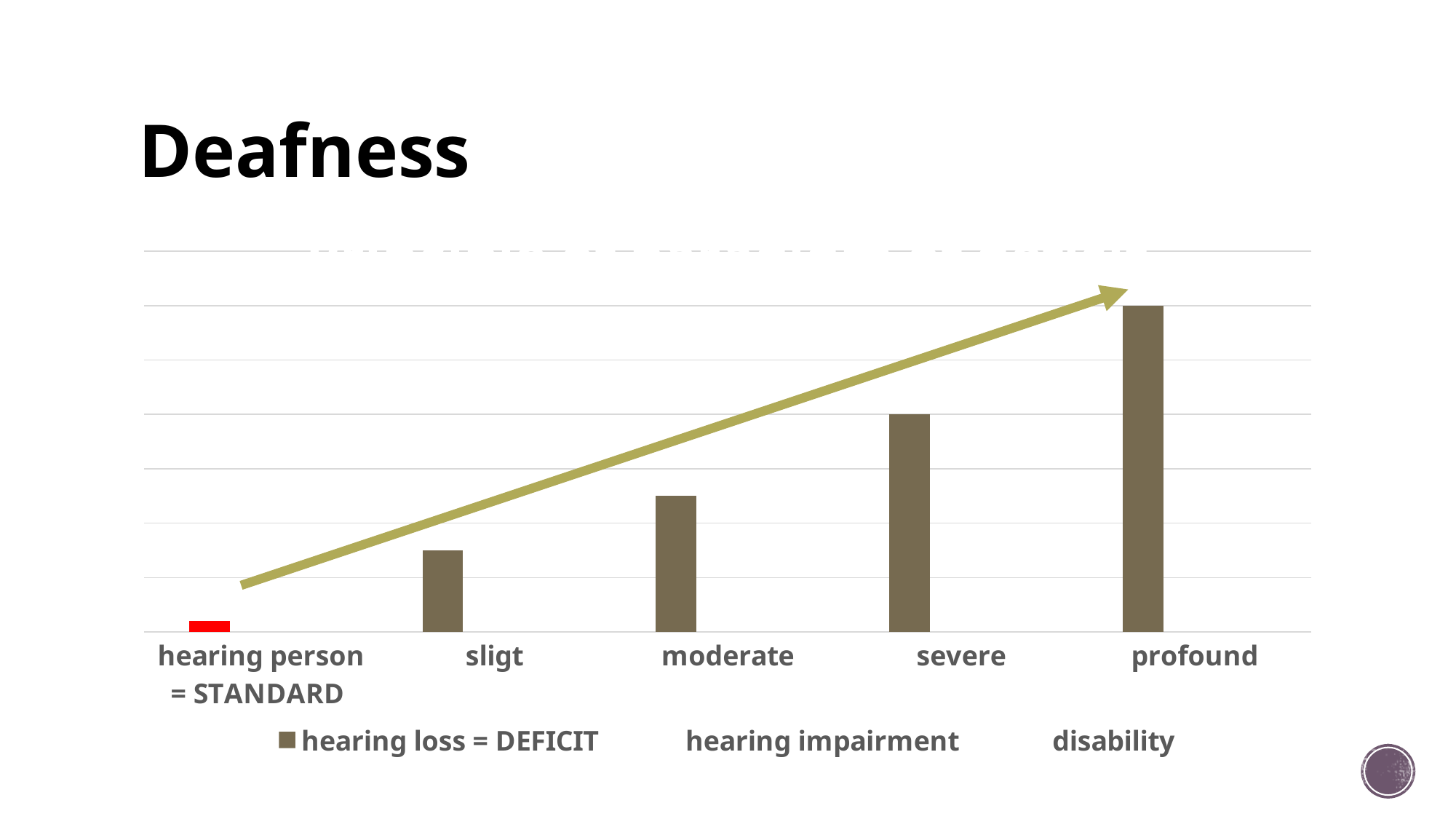
What kind of chart is shown on the slide? bar chart Do the bar heights rise or fall from left to right along the x axis? rise Which bar is taller, severe or moderate? severe What is the title of the slide containing the chart? Deafness Which bar is shorter, hearing person = STANDARD or sligt? hearing person = STANDARD Which category has the shortest bar in the chart? hearing person = STANDARD Which bar is taller, sligt or profound? profound How many categories are shown on the x axis of the chart? 5 What colour is the bar for hearing person = STANDARD? red Which category has the tallest bar in the chart? profound